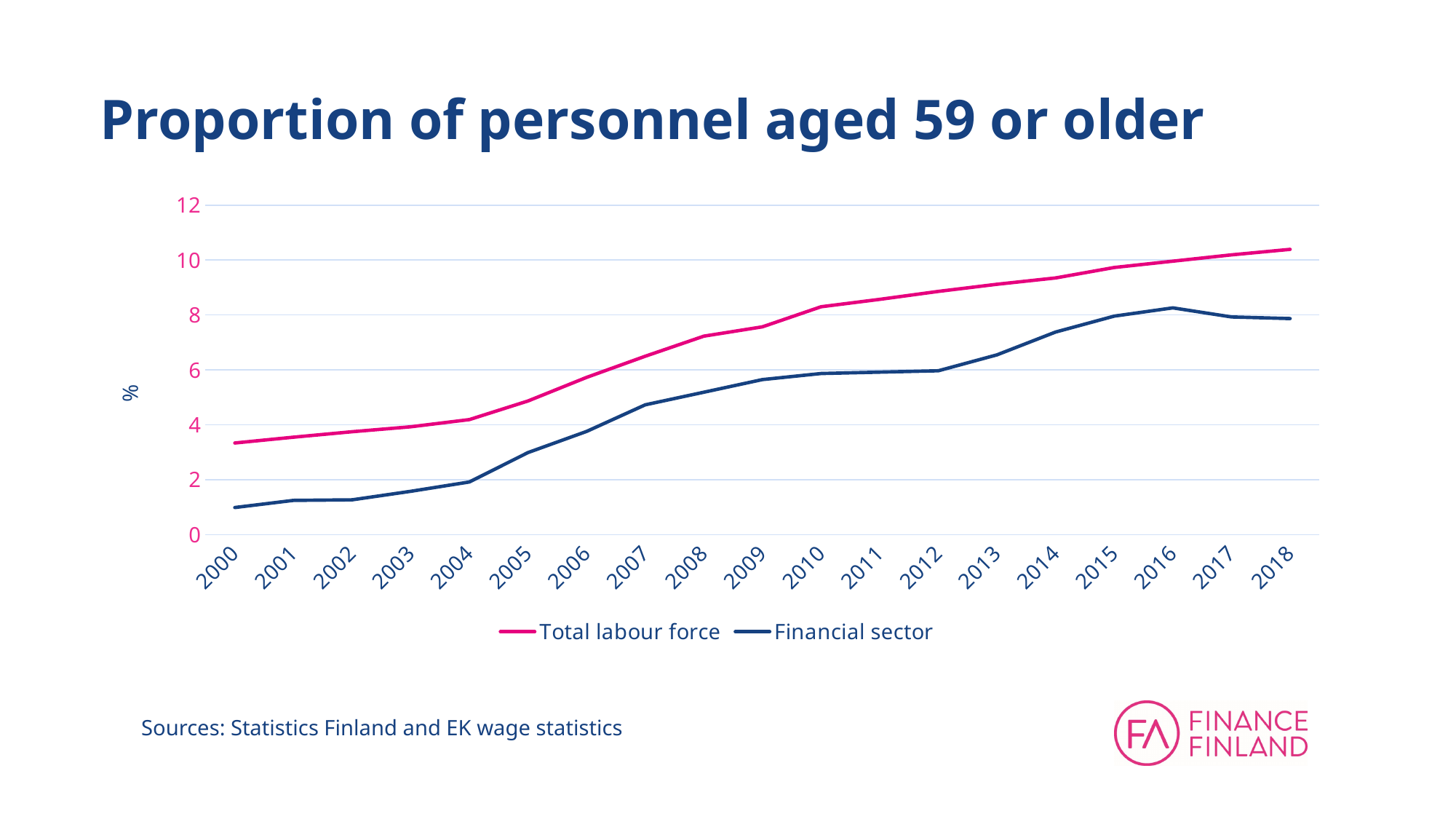
How many years are shown on the x axis? 19 Which series is plotted in pink? Total labour force Does the Total labour force series rise or fall from 2000 to 2018? rise Is the value for Total labour force in 2018 greater or less than 10? greater Is the value for Financial sector in 2000 greater or less than 2? less Is the value for Financial sector in 2014 greater or less than 6? greater In 2010, which series has the higher value, Total labour force or Financial sector? Total labour force In which year does the Financial sector series reach its highest value? 2016 How many series does the legend list? 2 What kind of chart is shown on the slide? line chart What is the title of the chart? Proportion of personnel aged 59 or older